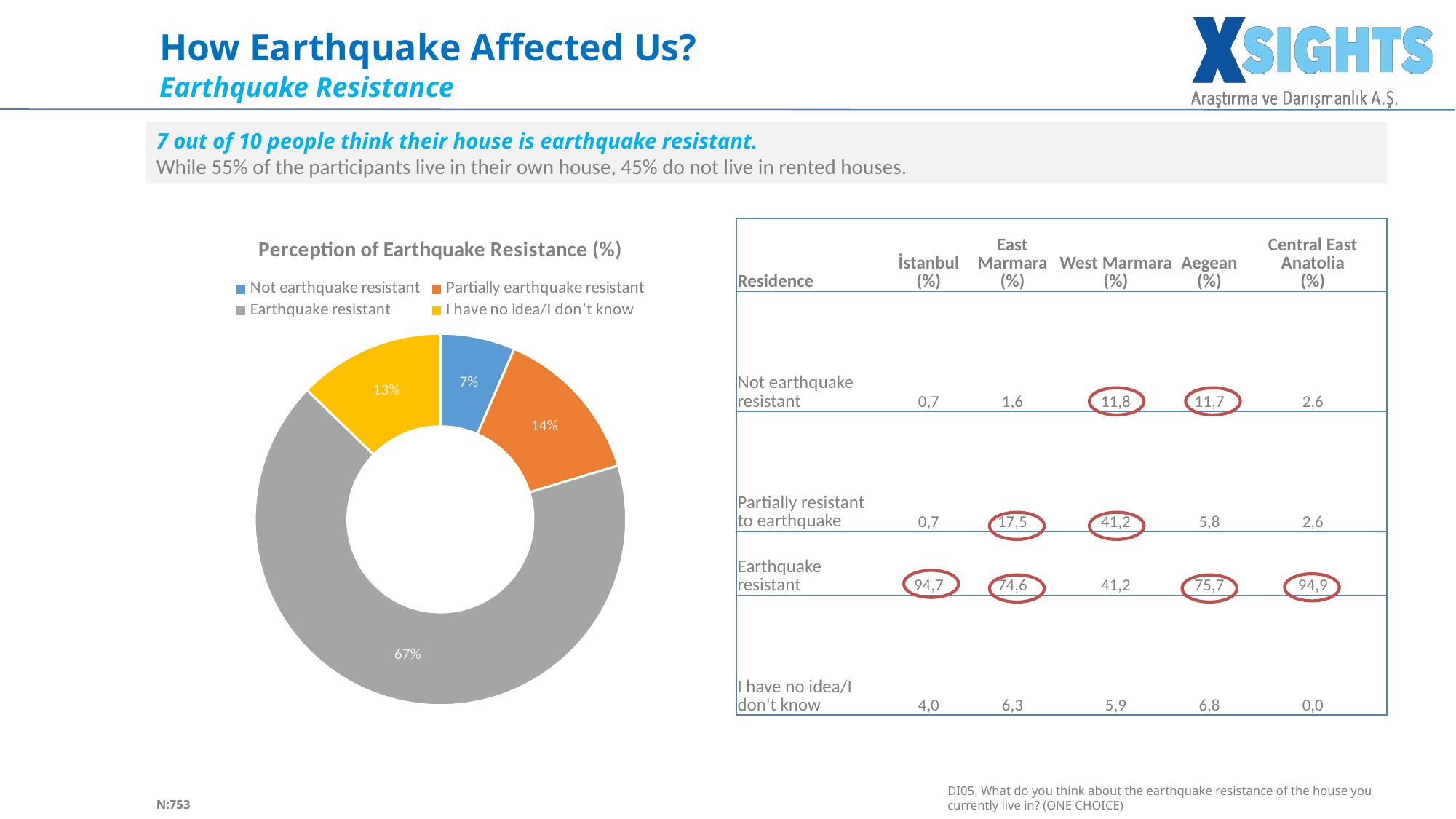
Which category has the smallest share in the Perception of Earthquake Resistance chart? Not earthquake resistant How many entries does the legend of the Perception of Earthquake Resistance chart list? 4 How many categories are shown in the Perception of Earthquake Resistance chart? 4 What colour represents 'Earthquake resistant' in the chart? Grey What is the difference in percentage points between 'Earthquake resistant' and 'Partially earthquake resistant'? 53 What value does the chart show for 'Not earthquake resistant'? 7% What percentage of the Perception of Earthquake Resistance chart is 'Earthquake resistant'? 67% Which category has the largest share in the Perception of Earthquake Resistance chart? Earthquake resistant What value does the chart show for 'I have no idea/I don't know'? 13% What type of chart is the Perception of Earthquake Resistance chart? Doughnut (pie) chart Which is larger: 'Partially earthquake resistant' or 'I have no idea/I don't know'? Partially earthquake resistant What value does the chart show for 'Partially earthquake resistant'? 14%